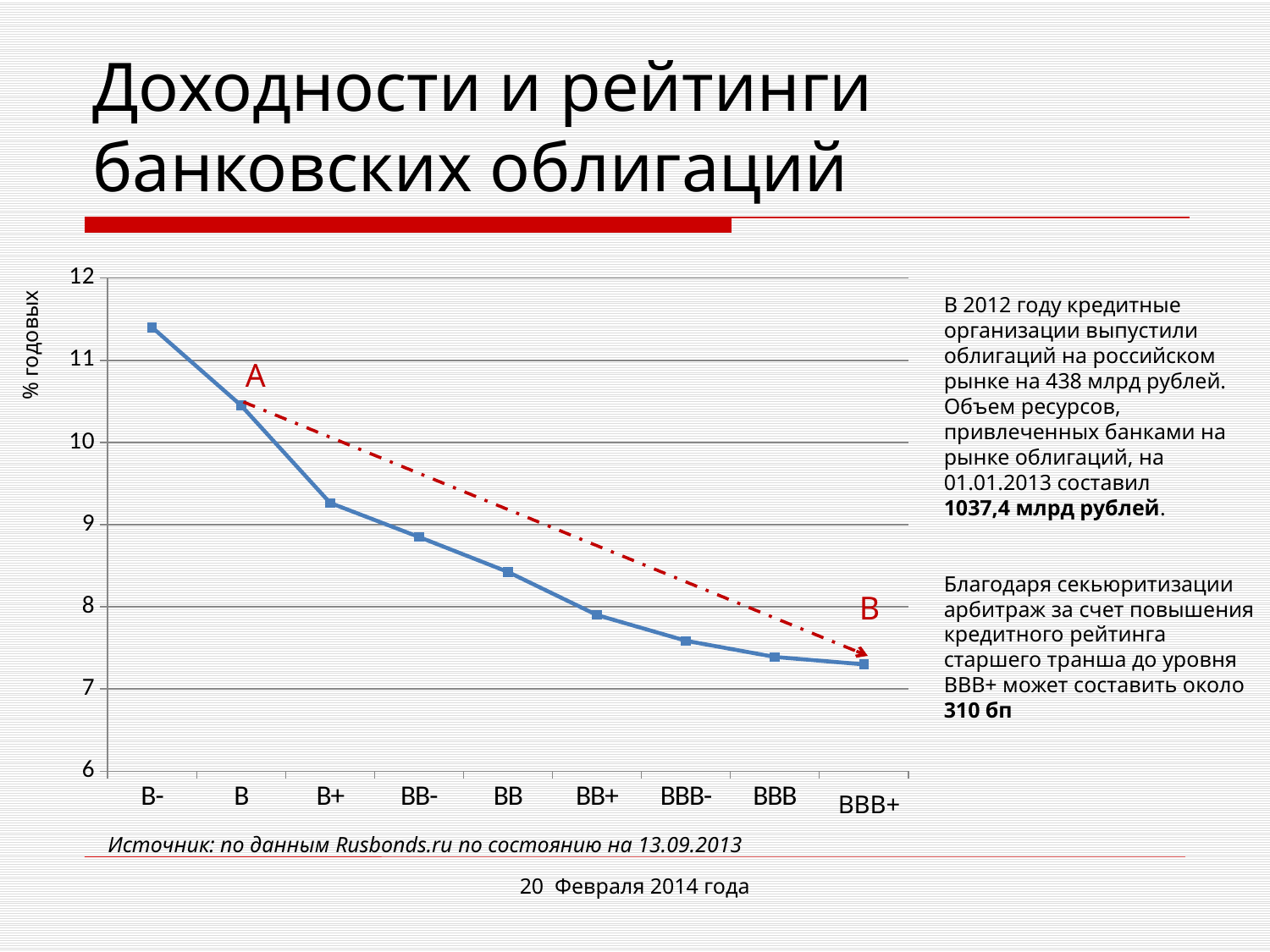
Is the value for B greater or less than 10? greater Which has the higher yield, B+ or BBB-? B+ Is the value for B+ greater or less than 9? greater What kind of chart is shown on the slide? line chart Is the value for BB- greater or less than 9? less How many rating categories are shown on the x axis? 9 Do the yields rise or fall as the rating moves from B- to BBB+ along the x axis? fall What is the label on the vertical axis of the chart? % годовых Which rating category has the highest yield? B-